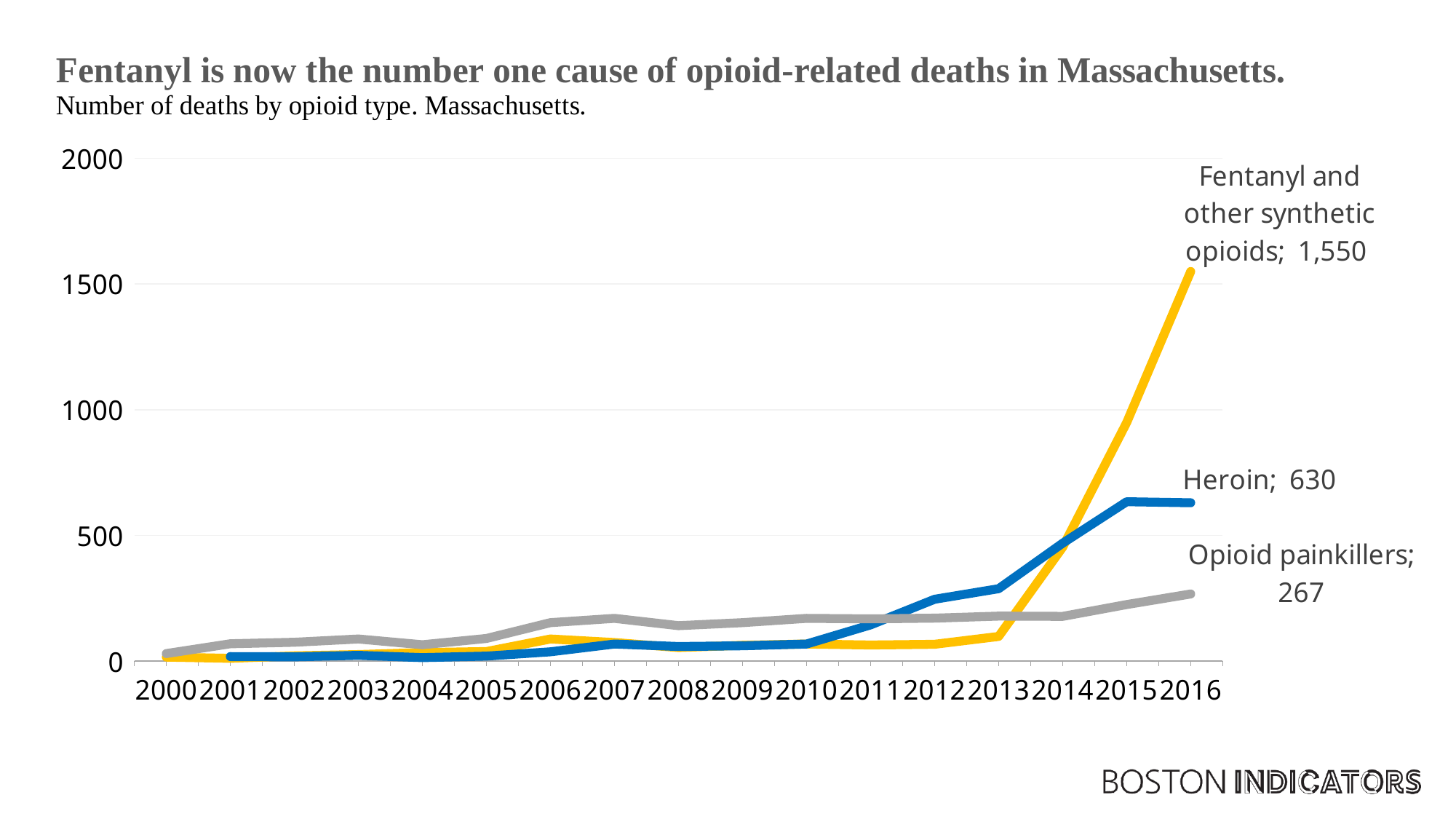
How many series are plotted on the chart? 3 Which series has the highest value in 2016? Fentanyl and other synthetic opioids What kind of chart is shown on the slide? line chart Is the value for Fentanyl and other synthetic opioids in 2014 greater or less than 1000? less Which series has the lowest value in 2016? Opioid painkillers Does the Fentanyl and other synthetic opioids line rise or fall from 2013 to 2016? rise What is the value for Heroin in 2016? 630 What is the difference between the 2016 values for Heroin and Opioid painkillers? 363 What is the value for Opioid painkillers in 2016? 267 What is the value for Fentanyl and other synthetic opioids in 2016? 1,550 What is the difference between the 2016 values for Fentanyl and other synthetic opioids and Heroin? 920 In 2016, which is larger: Heroin or Opioid painkillers? Heroin